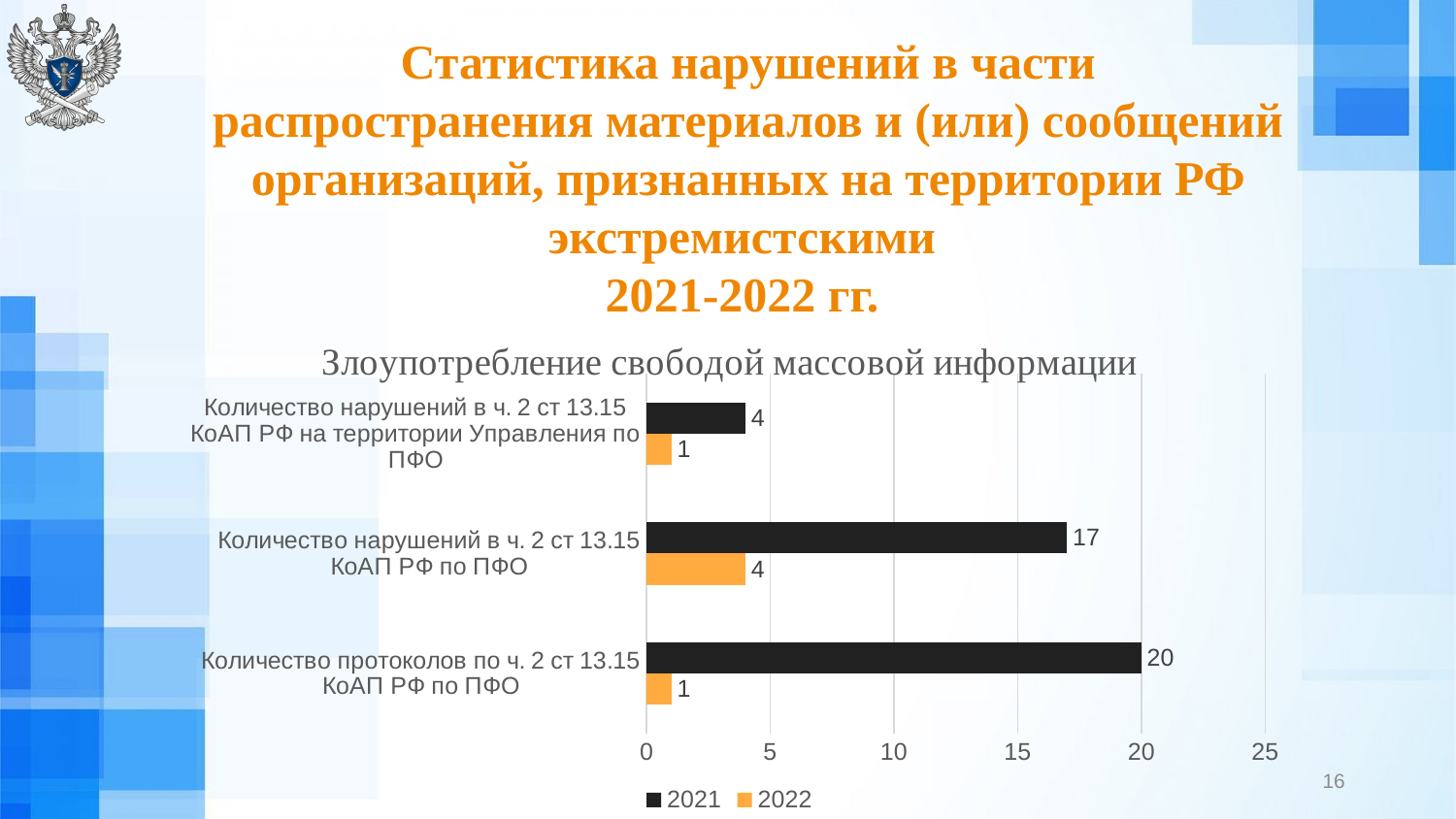
What is the 2022 value for 'Количество протоколов по ч. 2 ст 13.15 КоАП РФ по ПФО'? 1 What is the 2021 value for 'Количество нарушений в ч. 2 ст 13.15 КоАП РФ на территории Управления по ПФО'? 4 What is the 2022 value for 'Количество нарушений в ч. 2 ст 13.15 КоАП РФ по ПФО'? 4 What is the title of the chart? Злоупотребление свободой массовой информации What is the 2021 value for 'Количество протоколов по ч. 2 ст 13.15 КоАП РФ по ПФО'? 20 Which category has the lowest 2021 value? Количество нарушений в ч. 2 ст 13.15 КоАП РФ на территории Управления по ПФО What kind of chart is shown on the slide? bar chart Which is larger: the 2021 value for 'Количество протоколов по ч. 2 ст 13.15 КоАП РФ по ПФО' or the 2021 value for 'Количество нарушений в ч. 2 ст 13.15 КоАП РФ по ПФО'? Количество протоколов по ч. 2 ст 13.15 КоАП РФ по ПФО How many categories are shown on the chart? 3 What is the difference between the 2021 and 2022 values for 'Количество нарушений в ч. 2 ст 13.15 КоАП РФ по ПФО'? 13 How many series does the legend list? 2 Which category has the highest 2021 value? Количество протоколов по ч. 2 ст 13.15 КоАП РФ по ПФО